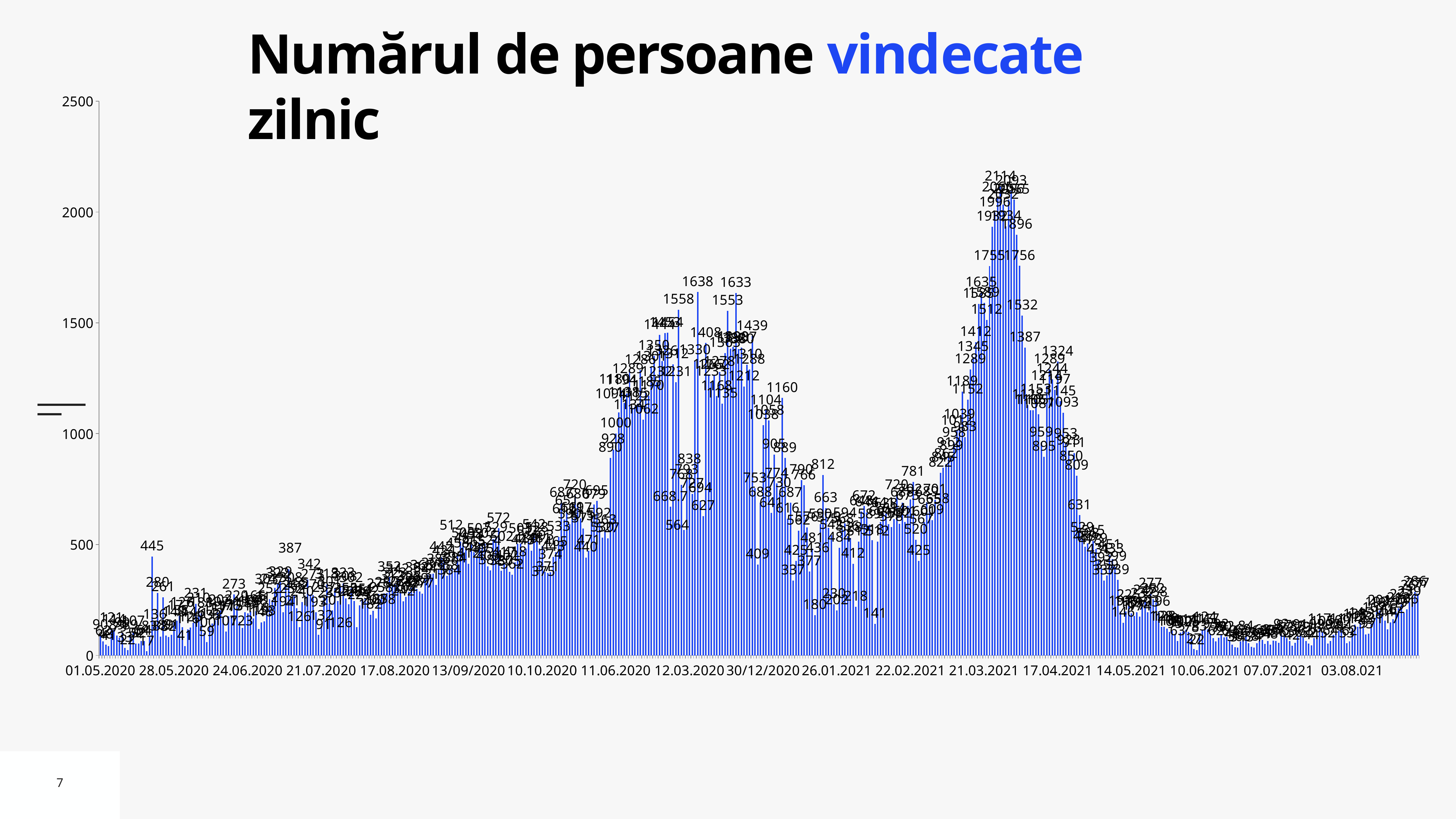
Is the tallest bar near 12.03.2020 greater or less than 1500? greater Which is larger, the peak labeled 2114 near 21.03.2021 or the peak labeled 1638 near 12.03.2020? 2114 Do the values rise or fall between 17.04.2021 and 10.06.2021? fall What is the difference between the highest labeled value, 2114, and the peak labeled 1638? 476 Is the highest bar on the chart greater or less than 2000? greater What is the first date label on the x axis? 01.05.2020 What kind of chart is shown on the slide? bar chart Is the bar labeled 445 near 28.05.2020 greater or less than 500? less What is the title of the chart? Numărul de persoane vindecate zilnic What is the highest value labeled on the chart? 2114 Do the values rise or fall between 22.02.2021 and 21.03.2021? rise